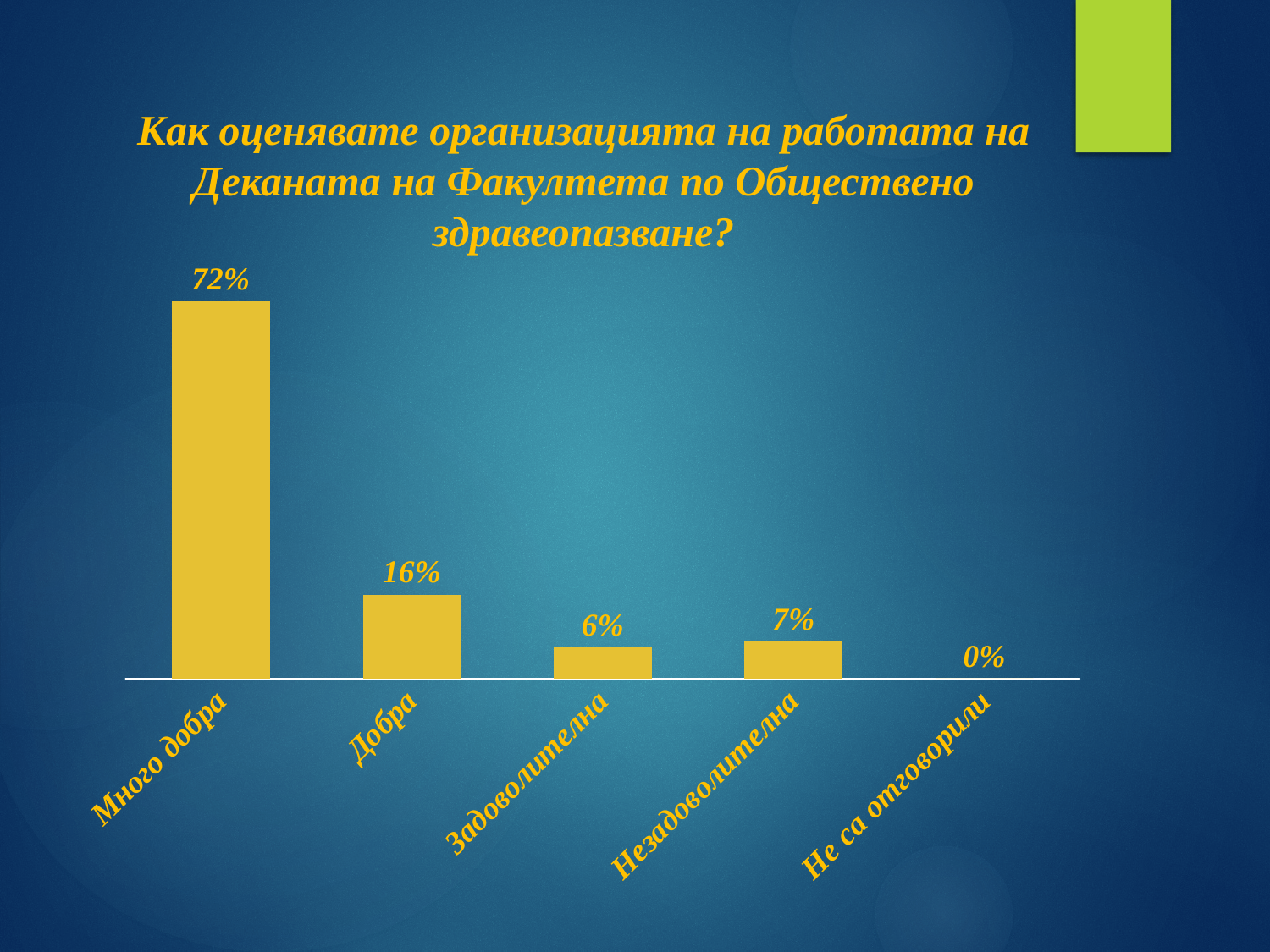
What colour are the bars in the chart? yellow Which category has the lowest value? Не са отговорили How many categories are shown on the x axis? 5 What kind of chart is shown on the slide? bar chart What is the value for Задоволителна? 6% What is the value for Много добра? 72% Which category has the highest value? Много добра Which is larger, the value for Задоволителна or the value for Незадоволителна? Незадоволителна What is the value for Незадоволителна? 7% What is the difference between the values for Много добра and Добра? 56% What is the value for Добра? 16% What is the value for Не са отговорили? 0%